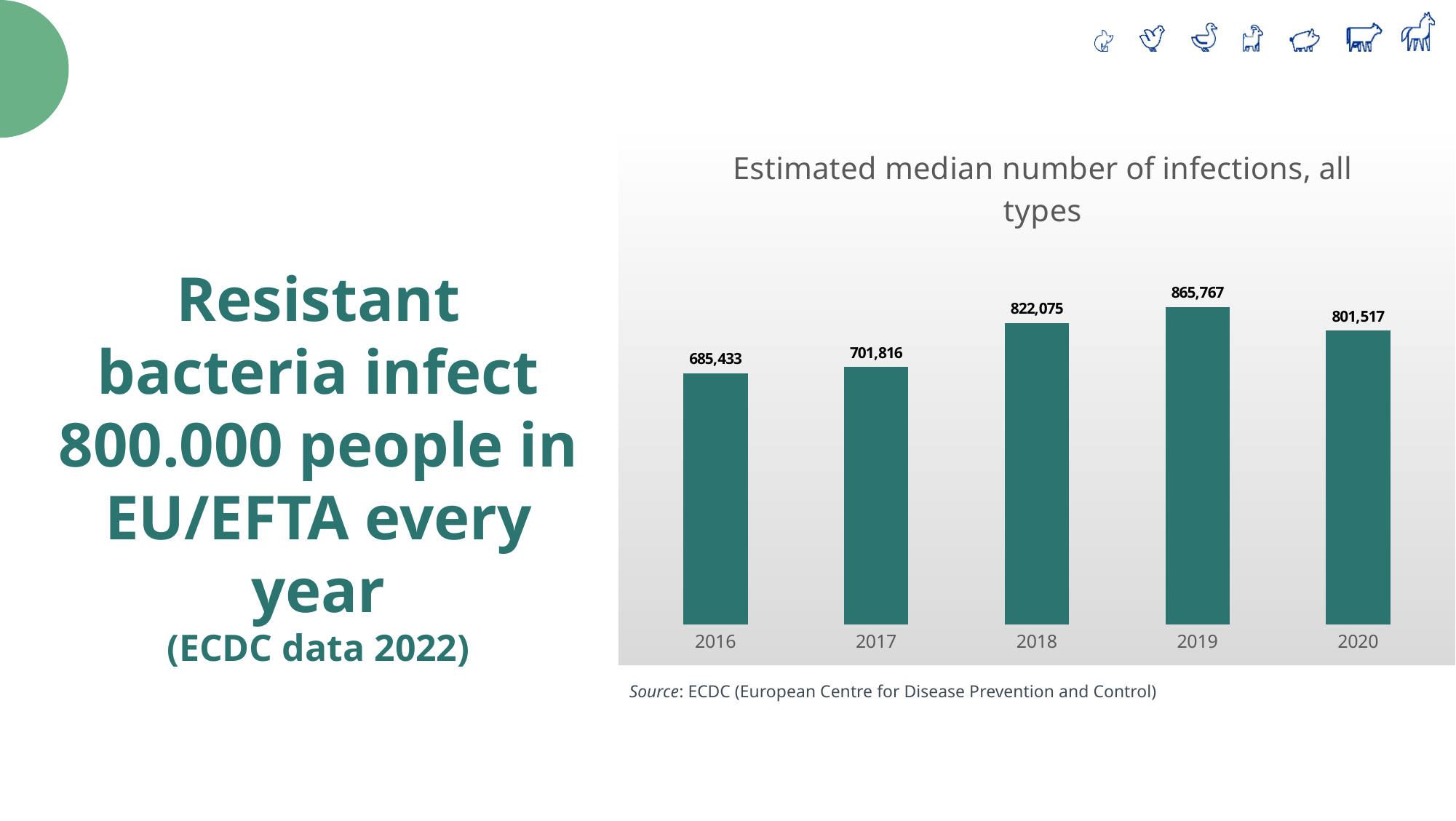
What is the difference between the values for 2019 and 2018? 43,692 What is the estimated median number of infections for 2020? 801,517 What is the title of the chart? Estimated median number of infections, all types Which year has the highest estimated median number of infections? 2019 What is the estimated median number of infections for 2016? 685,433 Which year has the lowest estimated median number of infections? 2016 What is the estimated median number of infections for 2018? 822,075 What kind of chart is shown on the slide? Bar chart How many years are shown on the chart? 5 Which year has a larger value, 2017 or 2020? 2020 By how much did the estimated median number of infections fall from 2019 to 2020? 64,250 Do the values rise or fall from 2016 to 2019? Rise